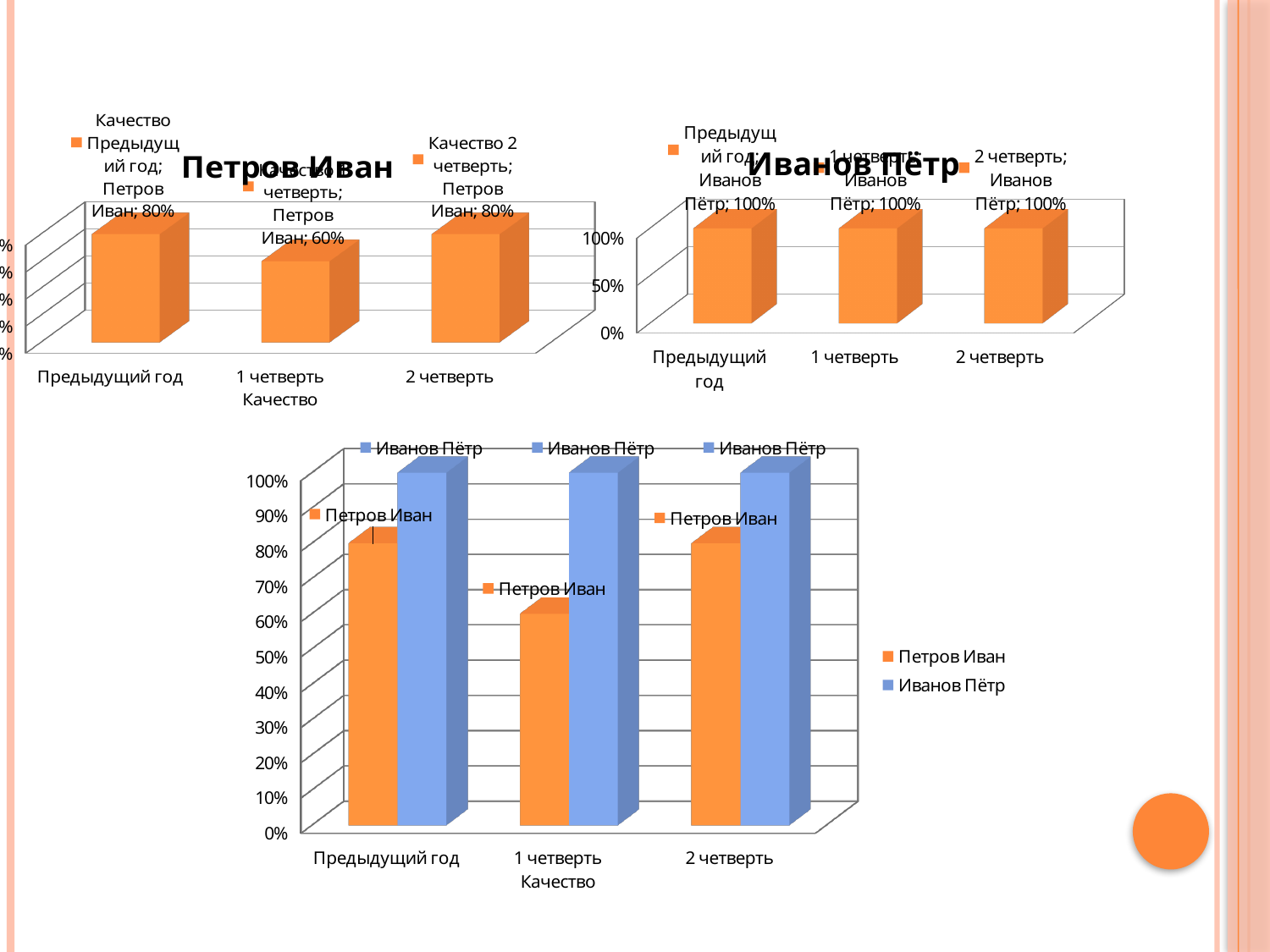
In the chart titled "Иванов Пётр", how many categories are shown on the x axis? 3 In the bottom chart, what colour are the bars for Иванов Пётр? Blue In the chart titled "Петров Иван", what is the value for 1 четверть? 60% In the bottom chart, which series has the larger value for 2 четверть, Петров Иван or Иванов Пётр? Иванов Пётр In the chart titled "Иванов Пётр", what is the value for 2 четверть? 100% In the bottom chart, is the value for Петров Иван in 1 четверть greater or less than 70%? less In the chart titled "Иванов Пётр", what kind of chart is it? Bar chart In the chart titled "Петров Иван", what is the value for Предыдущий год? 80% In the bottom chart, what is the label on the x axis? Качество In the chart titled "Петров Иван", which category has the lowest value? 1 четверть In the bottom chart, how many series does the legend list? 2 In the chart titled "Петров Иван", what is the difference between the value for Предыдущий год and the value for 1 четверть? 20%